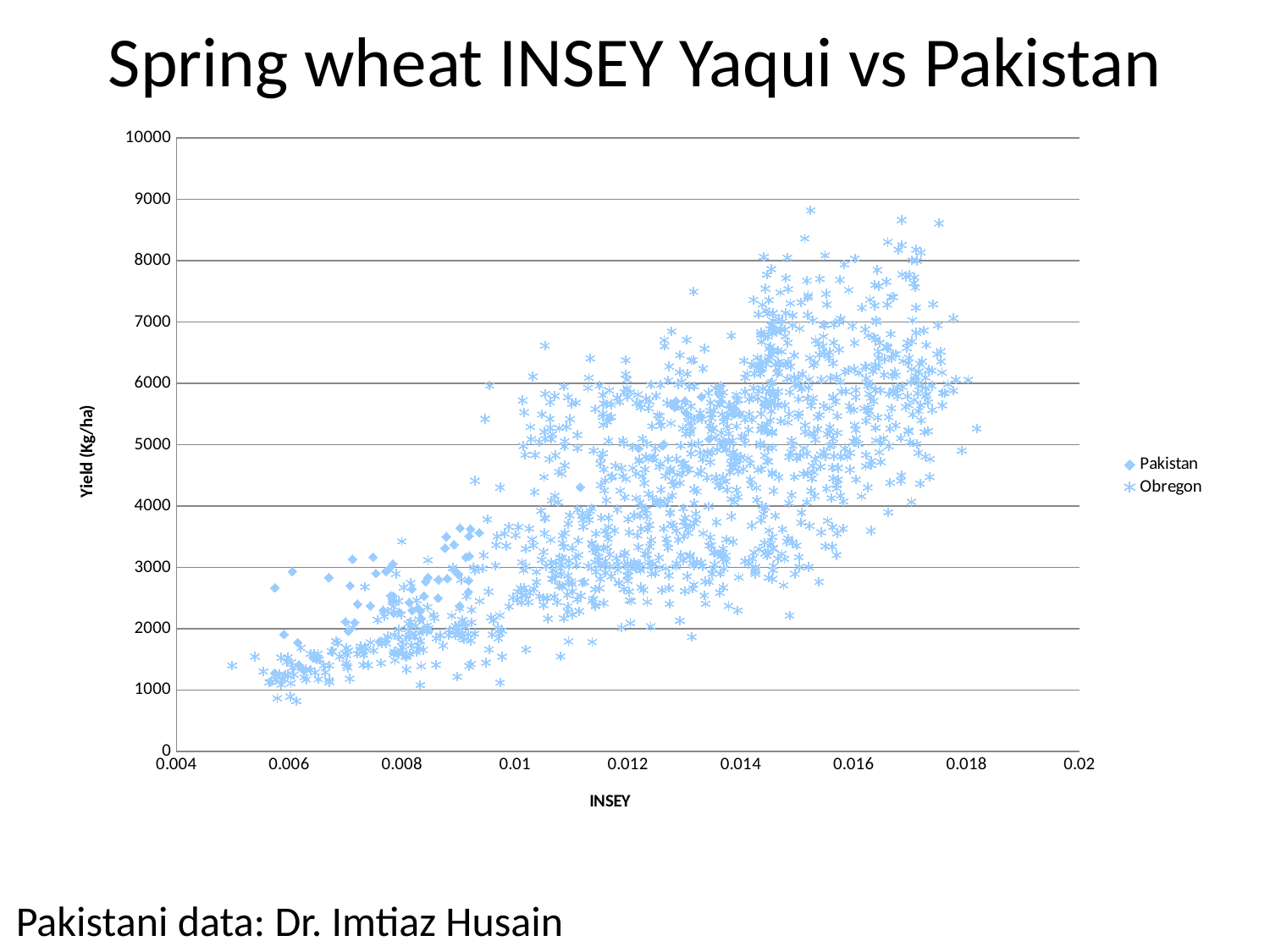
What is the minimum value shown on the x axis? 0.004 How many series does the legend list? 2 What is the label of the y axis? Yield (Kg/ha) What kind of chart is shown on the slide? scatter chart Is the highest plotted yield value greater or less than 9000? less What is the label of the x axis? INSEY What is the maximum value shown on the x axis? 0.02 What is the maximum value shown on the y axis? 10000 Do yield values generally rise or fall as INSEY increases along the x axis? rise Which series has more plotted points, Pakistan or Obregon? Obregon What is the title of the chart? Spring wheat INSEY Yaqui vs Pakistan What are the two series named in the legend? Pakistan and Obregon